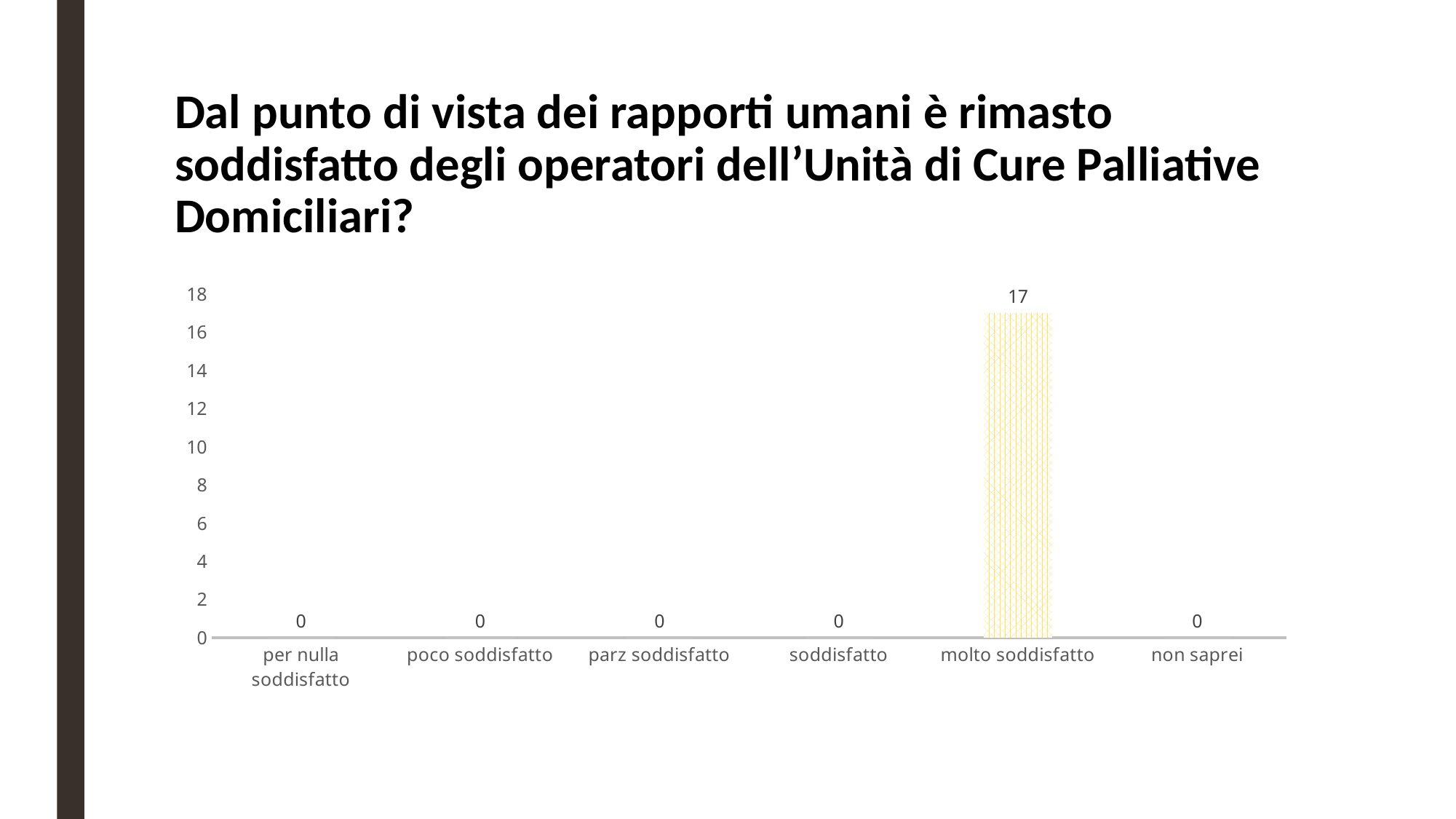
How many categories are shown on the x axis? 6 Which is larger, the value for "molto soddisfatto" or the value for "parz soddisfatto"? molto soddisfatto What is the total of all the values shown in the chart? 17 Which category has the highest value? molto soddisfatto What is the highest value shown on the y axis? 18 What is the value for "non saprei"? 0 How many categories have a value of 0? 5 What kind of chart is shown on the slide? bar chart What is the difference between the values for "molto soddisfatto" and "poco soddisfatto"? 17 What is the value for "molto soddisfatto"? 17 Is the value for "molto soddisfatto" greater or less than 16? greater What is the value for "soddisfatto"? 0